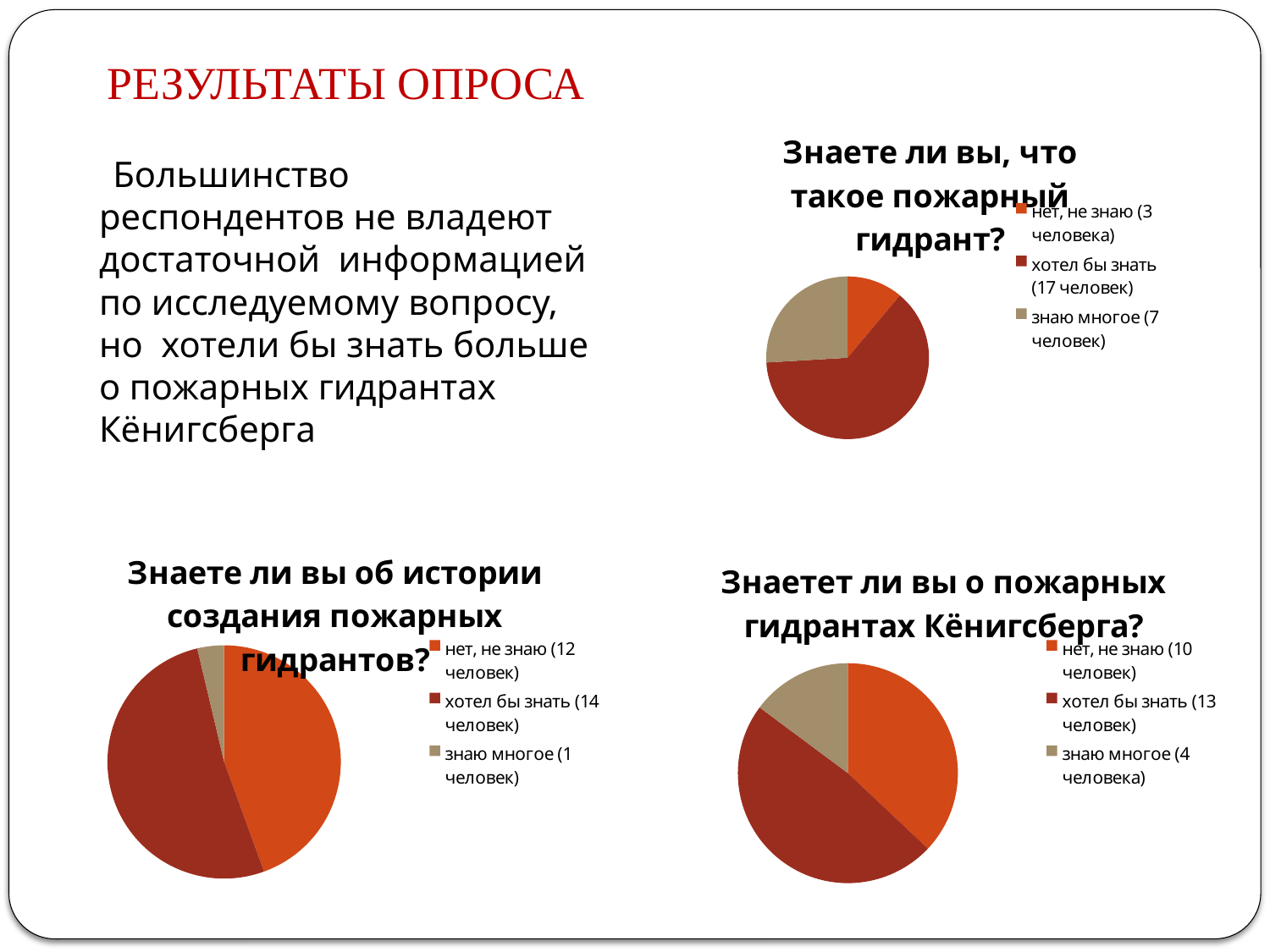
On the chart titled "Знаете ли вы, что такое пожарный гидрант?", what is the difference between the number who answered "хотел бы знать" and the number who answered "знаю многое"? 10 On the chart titled "Знаете ли вы, что такое пожарный гидрант?", how many people answered "хотел бы знать"? 17 человек On the chart titled "Знаете ли вы об истории создания пожарных гидрантов?", which answer has the smallest slice? знаю многое How many pie charts are shown on the slide? 3 On the chart titled "Знаете ли вы, что такое пожарный гидрант?", which answer has the largest slice? хотел бы знать On the chart titled "Знаетет ли вы о пожарных гидрантах Кёнигсберга?", how many people answered "нет, не знаю"? 10 человек What type of chart is used for "Знаете ли вы об истории создания пожарных гидрантов?"? pie chart On the chart titled "Знаете ли вы, что такое пожарный гидрант?", how many people answered "нет, не знаю"? 3 человека How many slices does the chart titled "Знаетет ли вы о пожарных гидрантах Кёнигсберга?" have? 3 On the chart titled "Знаетет ли вы о пожарных гидрантах Кёнигсберга?", which answer has the largest slice? хотел бы знать On the chart titled "Знаете ли вы об истории создания пожарных гидрантов?", how many people answered "знаю многое"? 1 человек On the chart titled "Знаетет ли вы о пожарных гидрантах Кёнигсберга?", which is larger: the number who answered "нет, не знаю" or the number who answered "знаю многое"? нет, не знаю